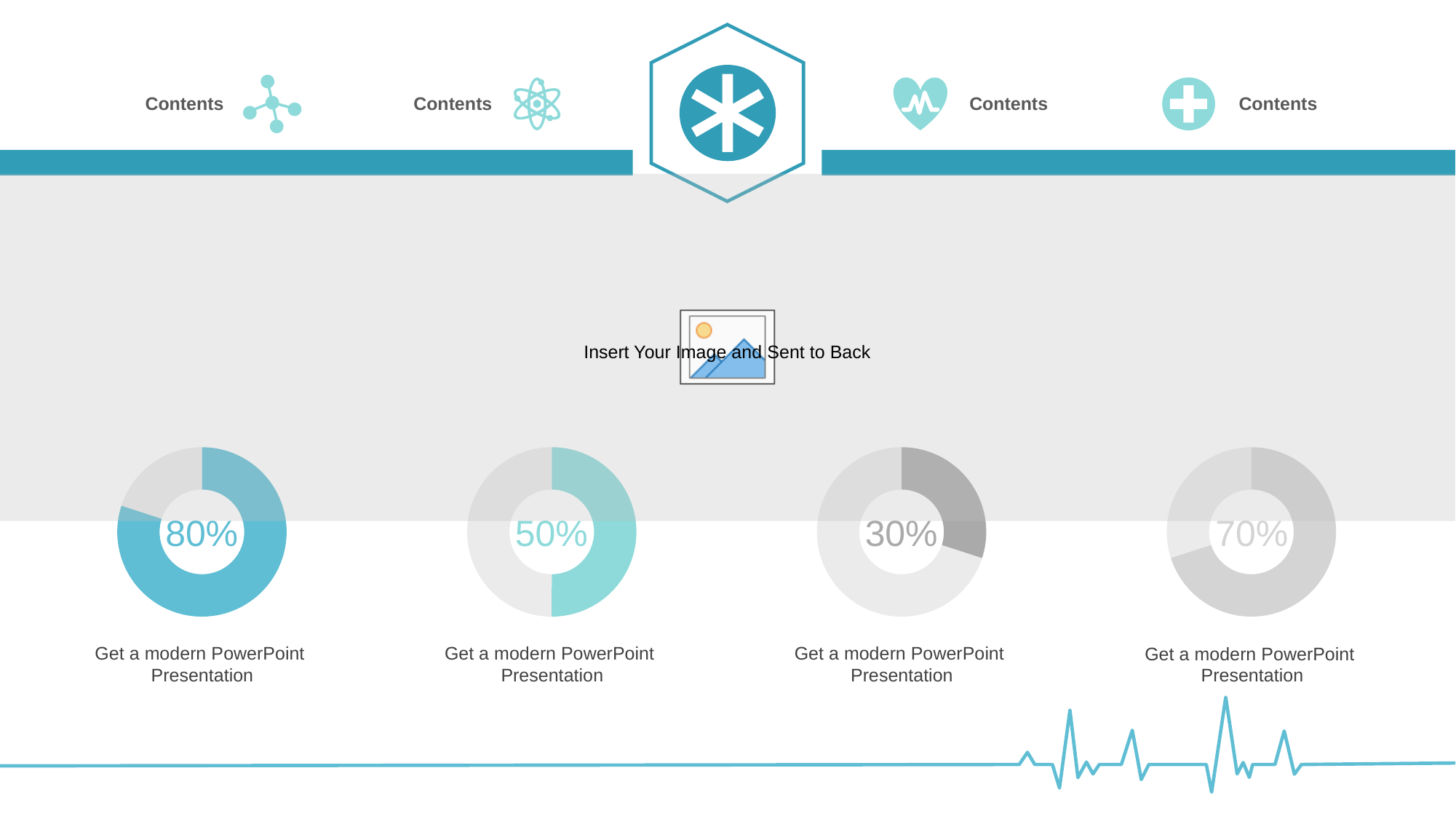
What type of chart is used to display the percentages on the slide? Donut chart What colour is the filled portion of the leftmost donut chart? Blue What percentage is shown in the leftmost donut chart? 80% How many donut charts are on the slide? 4 Which is larger: the percentage in the rightmost donut chart or the percentage in the second donut chart from the left? The rightmost (70%) What is the difference between the percentage in the leftmost donut chart and the percentage in the rightmost donut chart? 10% Which donut chart shows the highest percentage? The leftmost (80%) What percentage is shown in the rightmost donut chart? 70% Which donut chart shows the lowest percentage? The third from the left (30%) What percentage is shown in the third donut chart from the left? 30% What is the difference between the percentage in the second donut chart and the percentage in the third donut chart? 20% What percentage is shown in the second donut chart from the left? 50%